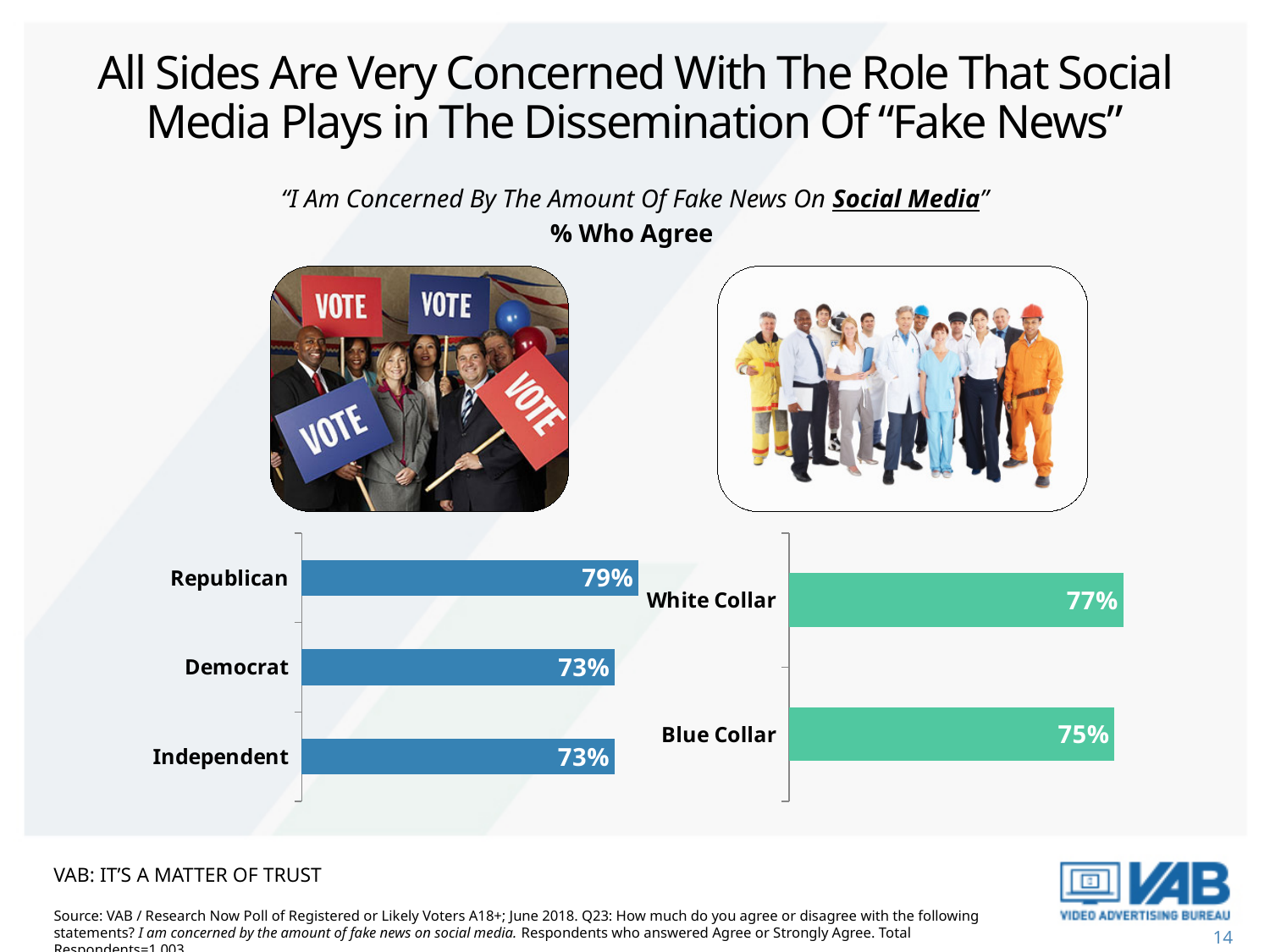
Which is larger: the Republican value in the left chart or the White Collar value in the right chart? Republican What kind of chart is the right chart (occupation)? Bar chart In the right chart (occupation), which category has the lowest value? Blue Collar In the right chart (occupation), what is the value for Blue Collar? 75% In the right chart (occupation), what is the value for White Collar? 77% What colour are the bars in the right chart (occupation)? Green In the left chart (political affiliation), what is the value for Democrat? 73% How many categories are shown in the left chart (political affiliation)? 3 In the left chart (political affiliation), what is the difference between the Republican and Democrat values? 6 percentage points In the left chart (political affiliation), which category has the highest value? Republican In the right chart (occupation), what is the difference between the White Collar and Blue Collar values? 2 percentage points In the left chart (political affiliation), what percentage of Republicans agree they are concerned by the amount of fake news on social media? 79%